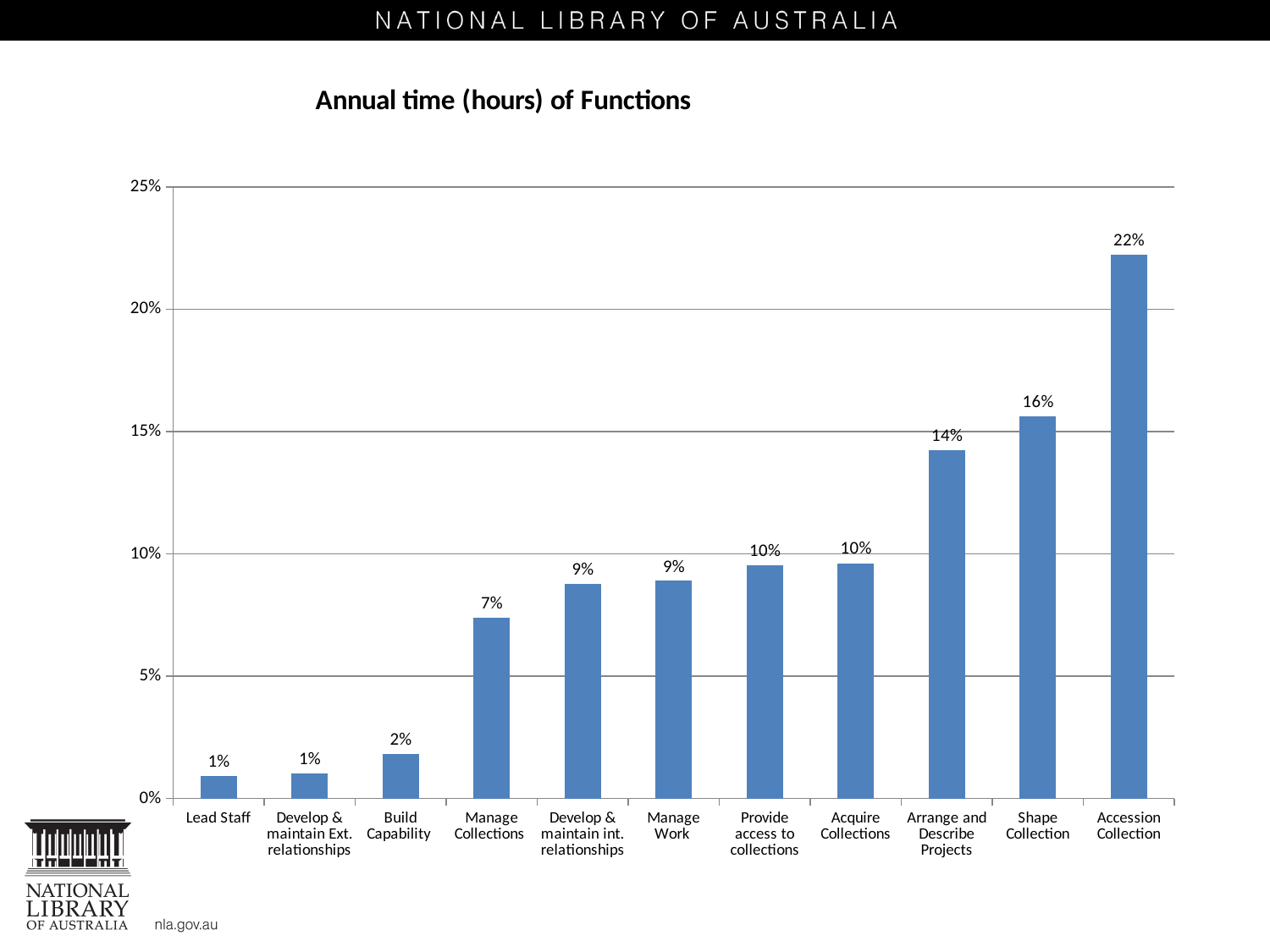
What is the value for Accession Collection? 22% Is the value for Shape Collection greater or less than 15%? greater Which function has the highest value? Accession Collection What is the value for Build Capability? 2% Is the value for Manage Work greater or less than 10%? less How many functions are shown on the x axis? 11 What is the difference between the values for Accession Collection and Shape Collection? 6% What is the title of the chart? Annual time (hours) of Functions What kind of chart is shown on the slide? Bar chart What is the value for Arrange and Describe Projects? 14% Which is larger, the value for Shape Collection or the value for Arrange and Describe Projects? Shape Collection What is the value for Manage Collections? 7%